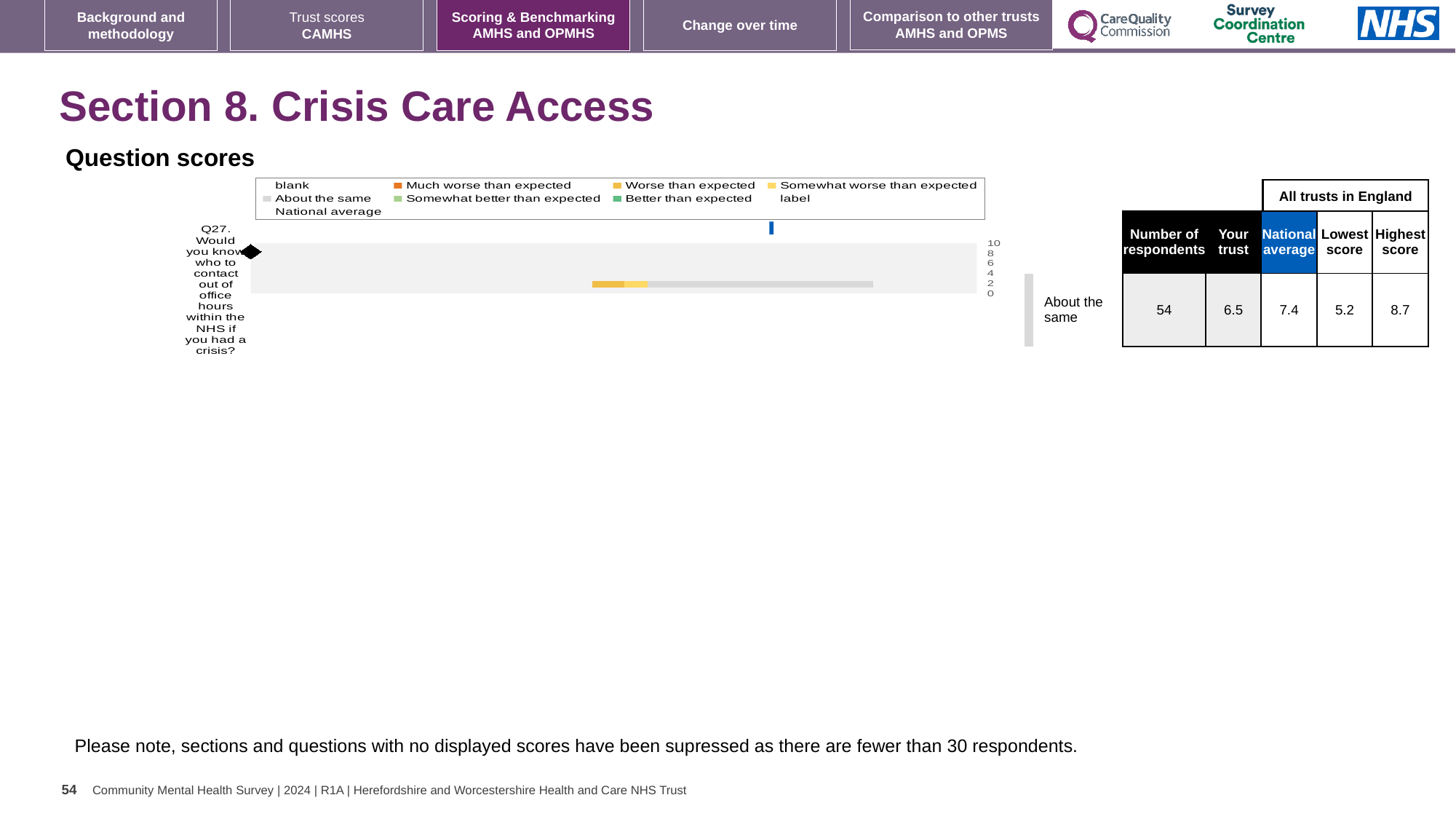
Which question is plotted in the Question scores chart? Q27. Would you know who to contact out of office hours within the NHS if you had a crisis? How many respondents answered Q27? 54 What is the highest score among all trusts in England for Q27? 8.7 What is the difference between the national average and the trust's score for Q27? 0.9 Which is larger for Q27, the trust's score or the national average? national average Is the trust's score for Q27 greater or less than 6 on the axis? greater What is the 'Your trust' score for Q27? 6.5 What is the national average score for Q27? 7.4 What is the lowest score among all trusts in England for Q27? 5.2 What benchmark category is shown next to the Q27 bar? About the same How many questions are plotted in the Question scores chart? 1 What kind of chart is used to show the question scores for Section 8? bar chart